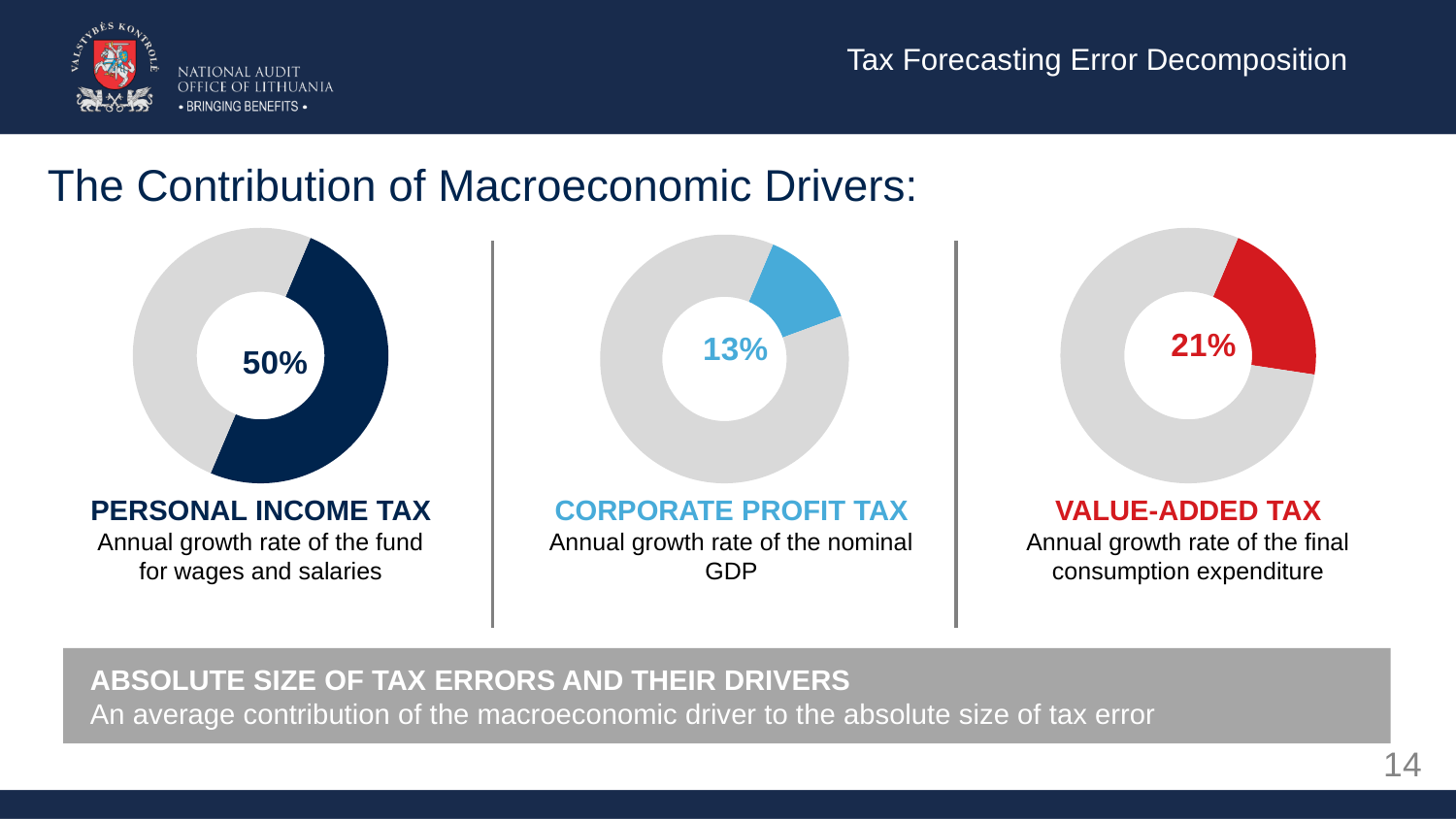
How many donut charts are shown on the slide? 3 What percentage is shown in the Value-Added Tax donut chart? 21% What percentage is shown in the Corporate Profit Tax donut chart? 13% What colour is the highlighted segment in the Value-Added Tax donut chart? Red Which of the three taxes has the lowest contribution percentage shown? Corporate Profit Tax Which macroeconomic driver is listed under the Corporate Profit Tax chart? Annual growth rate of the nominal GDP Which of the three taxes has the highest contribution percentage shown? Personal Income Tax What is the difference between the Personal Income Tax percentage and the Value-Added Tax percentage? 29% What kind of chart is used to show the contribution of each macroeconomic driver? Donut (pie) chart Which is larger, the Corporate Profit Tax percentage or the Value-Added Tax percentage? Value-Added Tax What percentage is shown in the Personal Income Tax donut chart? 50% What is the difference between the Value-Added Tax percentage and the Corporate Profit Tax percentage? 8%